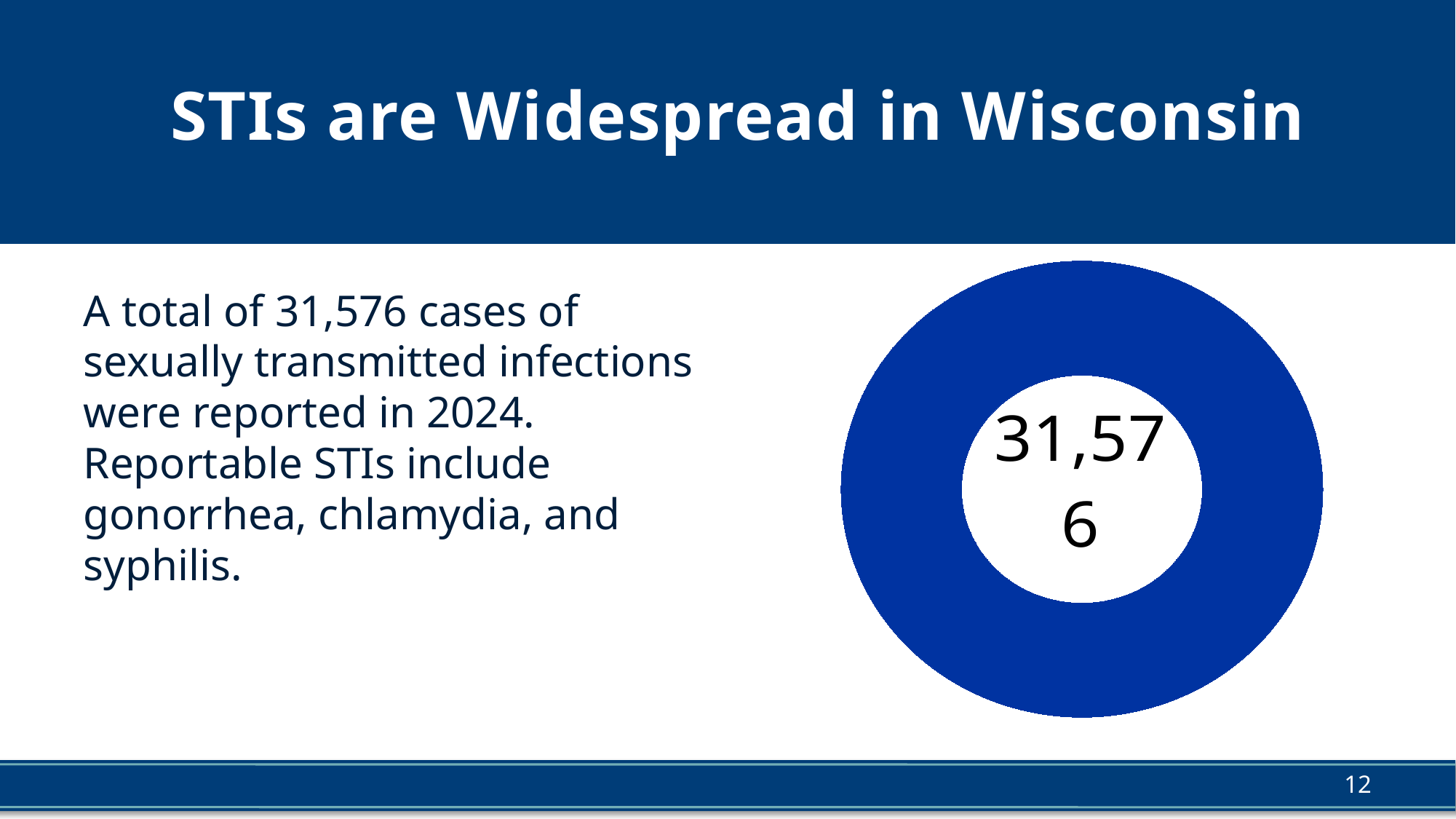
What share of the doughnut chart does the single blue slice occupy? 100% What number is printed in the center of the doughnut chart? 31,576 What kind of chart is shown on the slide? doughnut chart How many slices does the doughnut chart have? 1 What colour is the ring of the doughnut chart? blue Does the doughnut chart show a legend? No